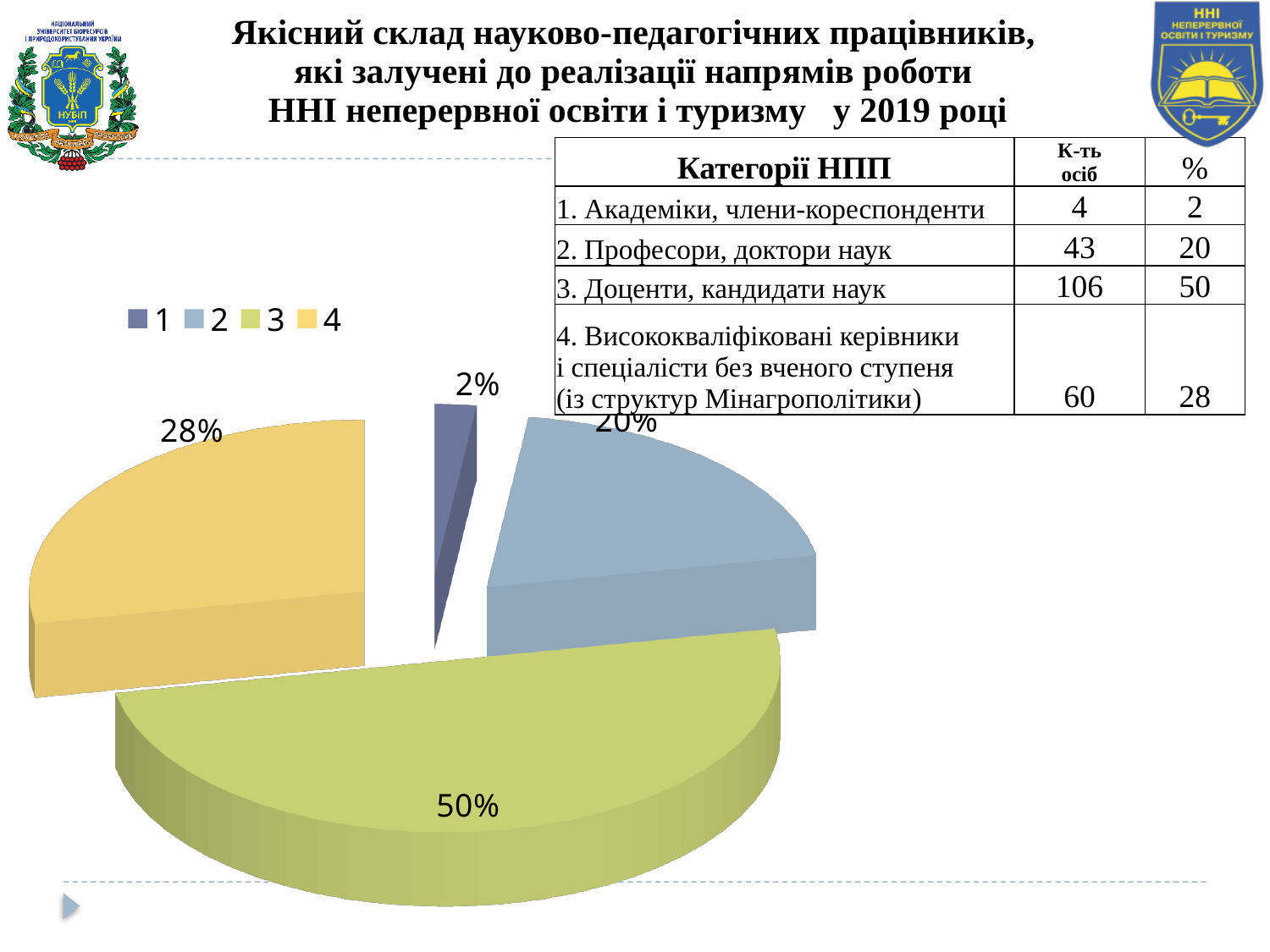
What kind of chart is shown on the slide? pie chart What percentage is shown for slice 3 in the pie chart? 50% What percentage is shown for slice 4 in the pie chart? 28% Which is larger in the pie chart, slice 2 or slice 4? 4 What colour is slice 3 in the pie chart? green What is the difference in percentage points between slice 3 and slice 4 in the pie chart? 22 What percentage is shown for slice 1 in the pie chart? 2% How many entries does the pie chart legend list? 4 Which slice of the pie chart is the largest? 3 Which slice of the pie chart is the smallest? 1 What percentage is shown for slice 2 in the pie chart? 20% How many slices does the pie chart have? 4